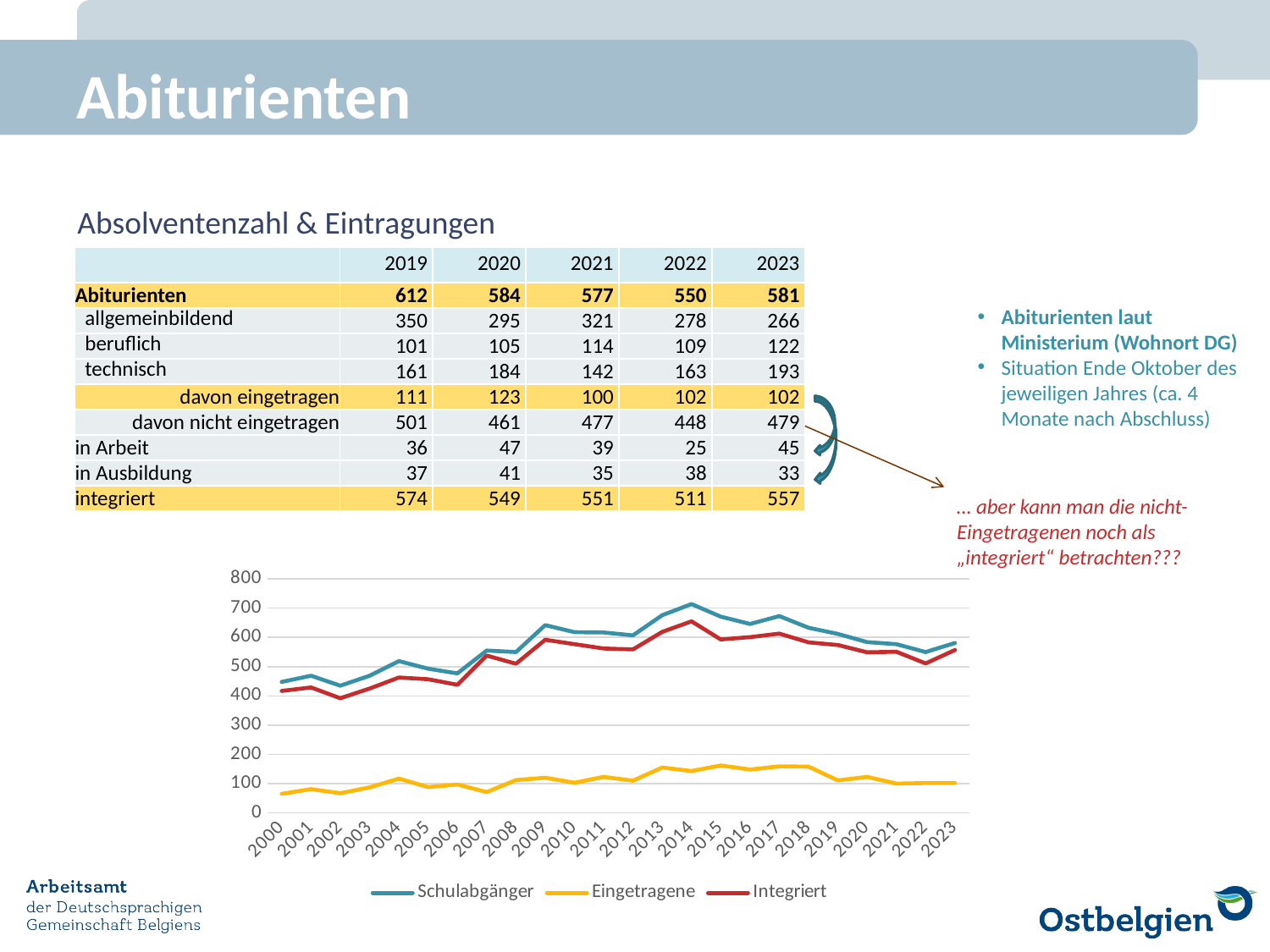
How many years are plotted along the x axis of the line chart? 24 In which year does the Schulabgänger line reach its highest value? 2014 Is the value for Schulabgänger in 2014 greater or less than 600? greater How many series does the legend of the line chart list? 3 What are the three series named in the legend of the line chart? Schulabgänger, Eingetragene, Integriert Is the value for Eingetragene in 2014 greater or less than 200? less What is the highest value shown on the y axis of the line chart? 800 What kind of chart is shown at the bottom of the slide? line chart Is the value for Eingetragene in 2015 greater or less than 100? greater In 2010, which series has the larger value: Eingetragene or Integriert? Integriert Does the Schulabgänger line rise or fall between 2014 and 2022? fall